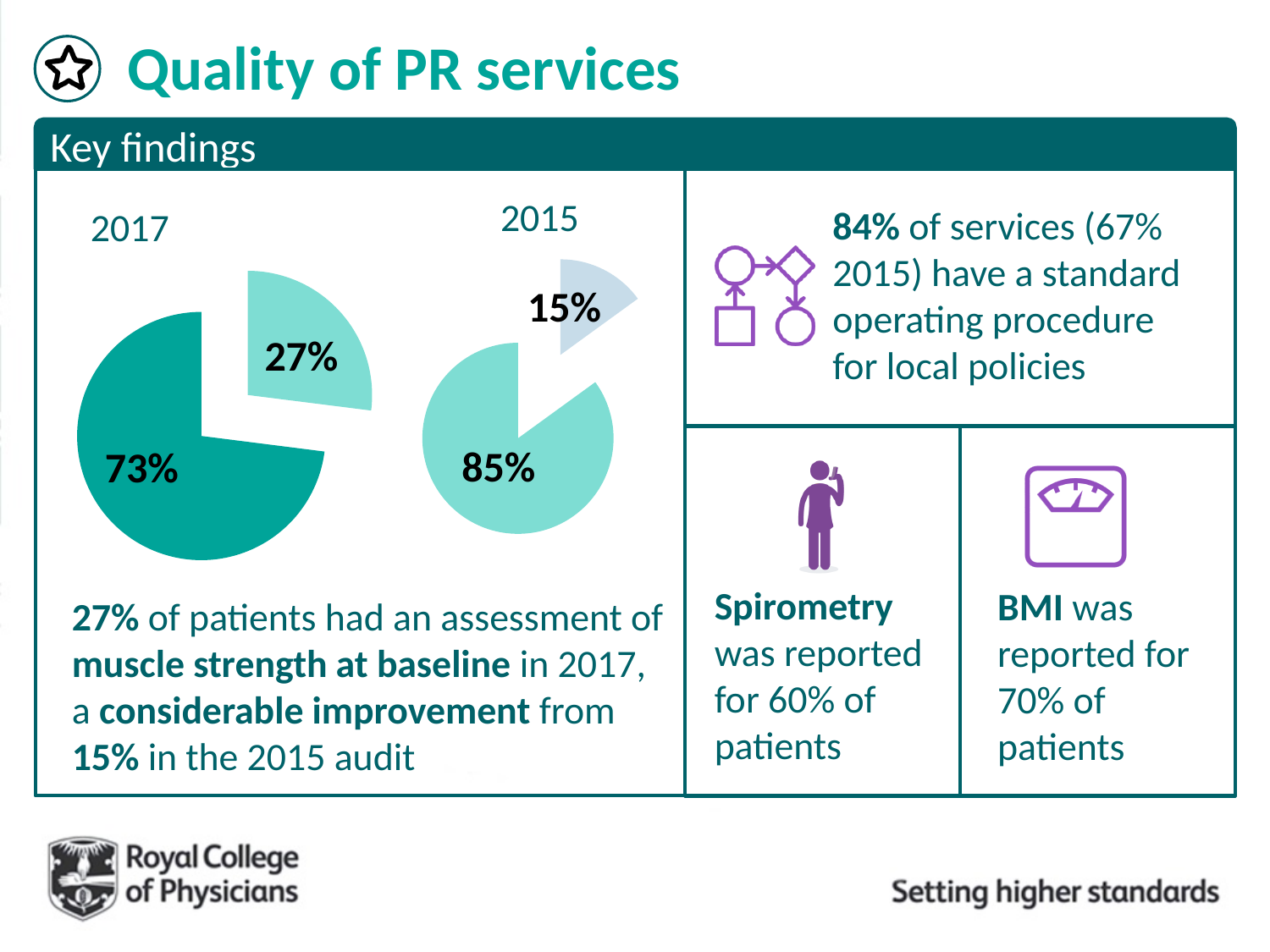
In the 2015 pie chart, what percentage is shown for the larger slice? 85% Which slice is larger in the 2017 pie chart, the 73% slice or the 27% slice? 73% In the 2017 pie chart, what percentage is shown for the smaller, exploded slice? 27% Which pie chart has the larger exploded slice, 2017 or 2015? 2017 What kind of chart is used to show the 2017 and 2015 figures on the left of the slide? Pie chart What year labels are shown above the two pie charts? 2017 and 2015 How many slices does the 2017 pie chart have? 2 How many slices does the 2015 pie chart have? 2 In the 2015 pie chart, what percentage is shown for the smaller, exploded slice? 15% What is the difference between the two slices in the 2015 pie chart? 70% What is the difference between the smaller slice of the 2017 pie chart (27%) and the smaller slice of the 2015 pie chart (15%)? 12% In the 2017 pie chart, what percentage is shown for the larger slice? 73%